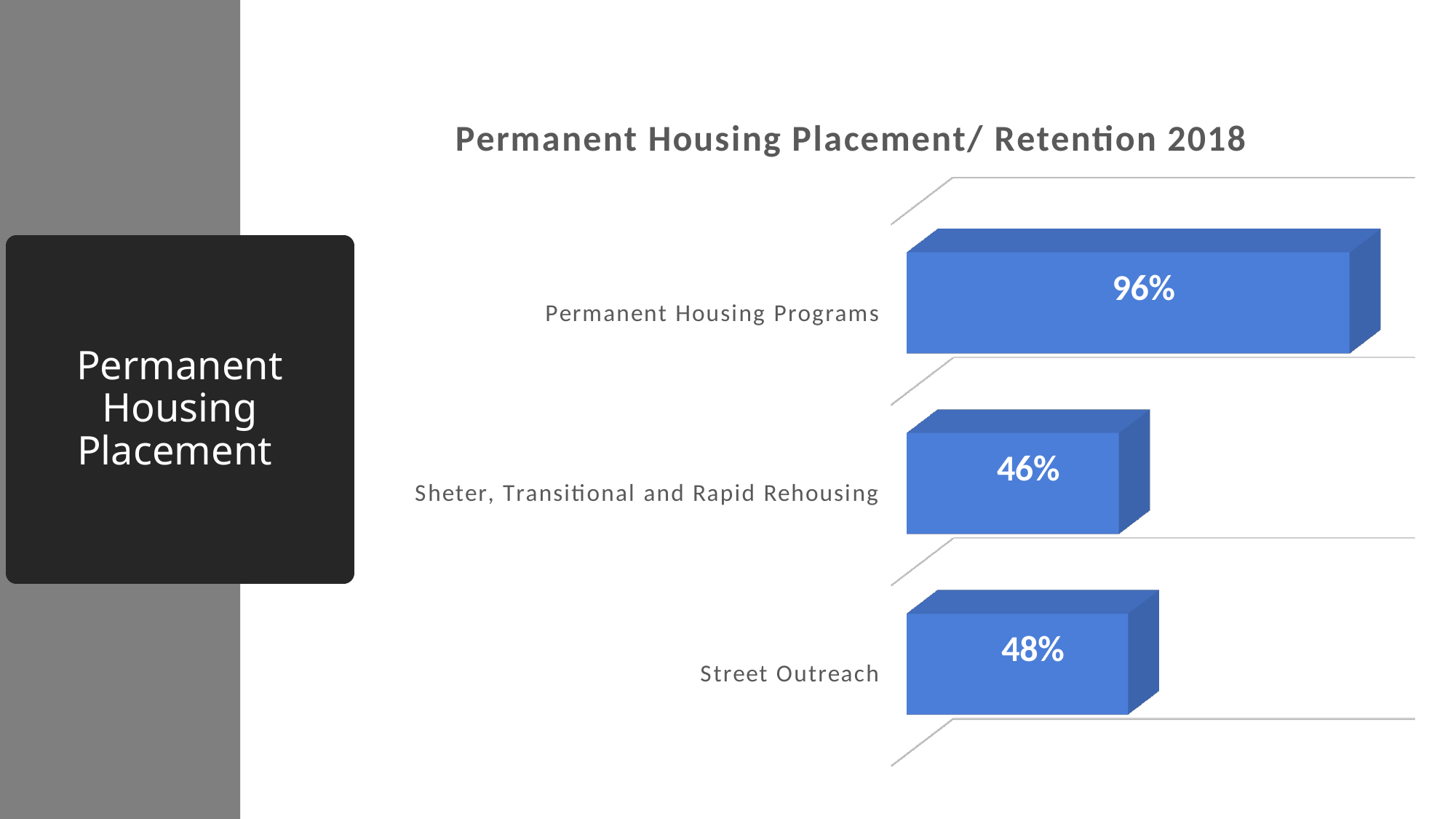
How many categories are shown in the chart? 3 Which category has the highest value? Permanent Housing Programs What is the difference between the values for Street Outreach and Sheter, Transitional and Rapid Rehousing? 2% What is the value for Street Outreach? 48% What colour are the bars in the chart? Blue Which category has the lowest value? Sheter, Transitional and Rapid Rehousing Which is larger, the value for Permanent Housing Programs or the value for Street Outreach? Permanent Housing Programs What kind of chart is shown on the slide? Bar chart What is the value for Sheter, Transitional and Rapid Rehousing? 46% What is the value for Permanent Housing Programs? 96% What is the title of the chart? Permanent Housing Placement/ Retention 2018 What is the difference between the values for Permanent Housing Programs and Street Outreach? 48%